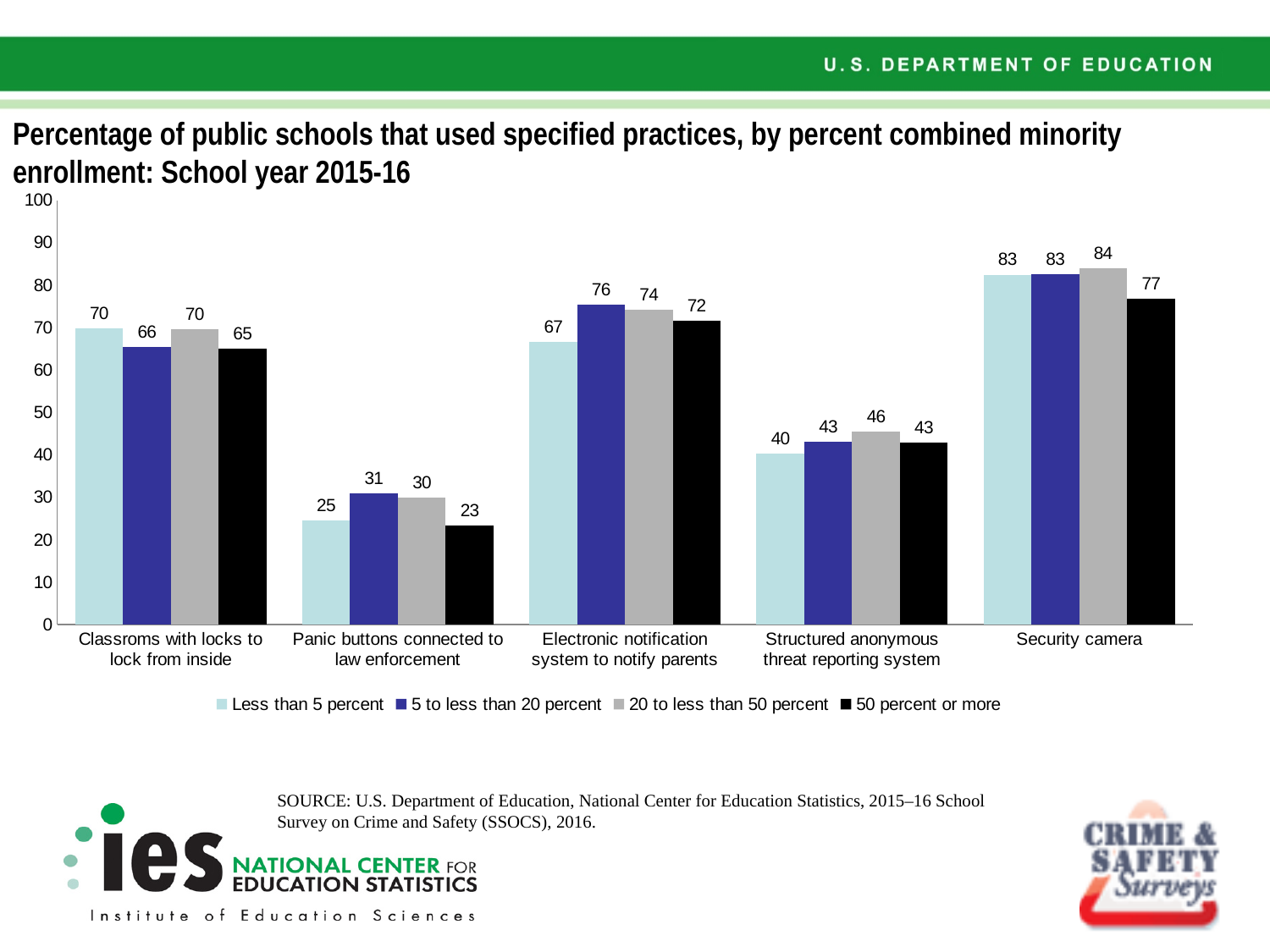
Which practice has the highest value in the '20 to less than 50 percent' series? Security camera How many series does the legend list? 4 What is the difference between the 'Less than 5 percent' and '50 percent or more' values for 'Electronic notification system to notify parents'? 5 What is the value for 'Classroms with locks to lock from inside' in the '5 to less than 20 percent' series? 66 How many practices (categories) are shown on the x axis? 5 What is the value for 'Security camera' in the '50 percent or more' series? 77 Which series is shown in black in the legend? 50 percent or more What is the value for 'Electronic notification system to notify parents' in the '5 to less than 20 percent' series? 76 What kind of chart is shown on the slide? Bar chart What is the value for 'Panic buttons connected to law enforcement' in the 'Less than 5 percent' series? 25 Which practice has the lowest value in the '50 percent or more' series? Panic buttons connected to law enforcement For 'Structured anonymous threat reporting system', which is larger: the 'Less than 5 percent' value or the '20 to less than 50 percent' value? 20 to less than 50 percent